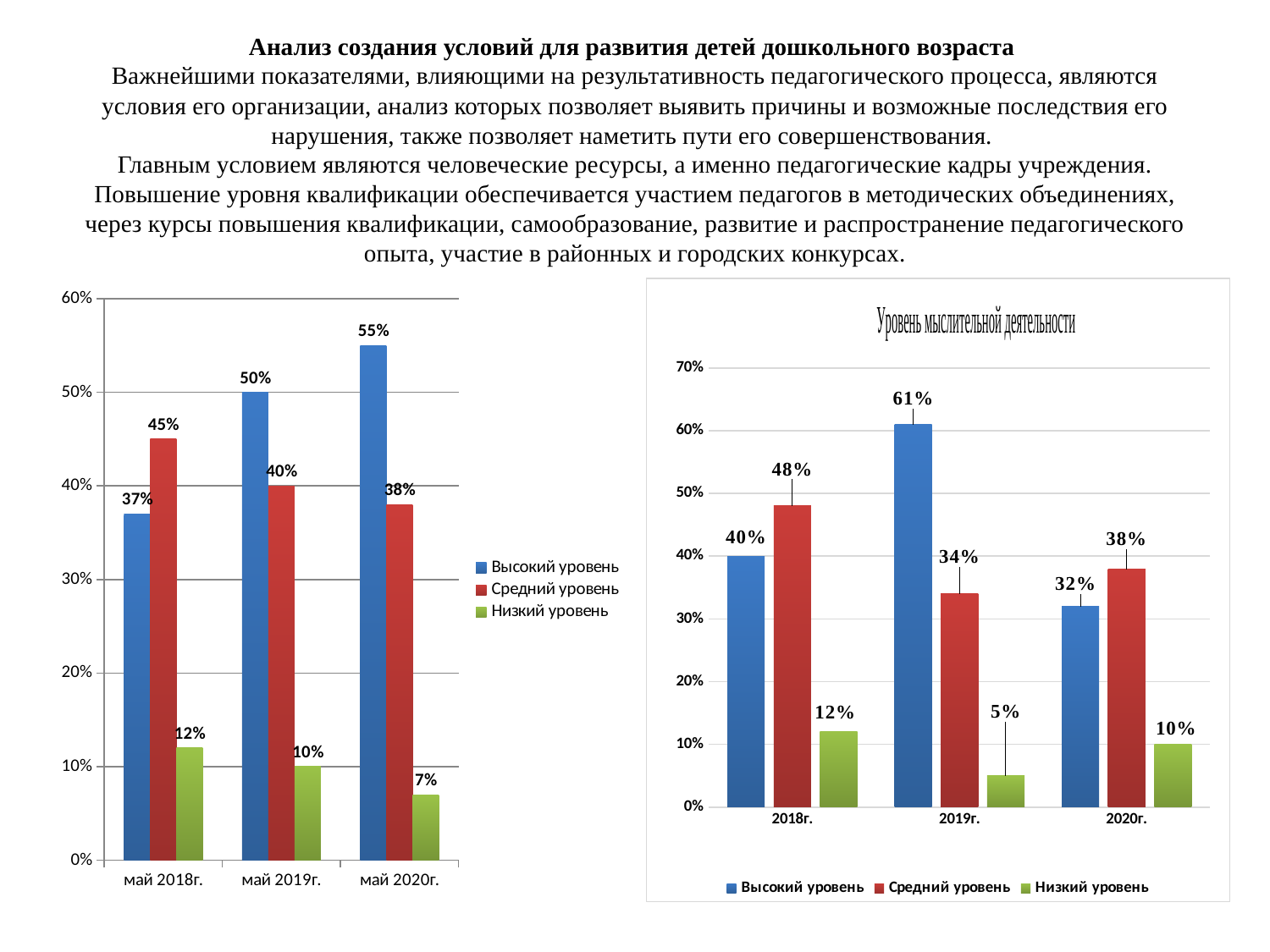
In the left chart, which category has the highest value for Высокий уровень? май 2020г. In the left chart, does Высокий уровень rise or fall from май 2018г. to май 2020г.? rise In the chart titled 'Уровень мыслительной деятельности', what is the value for Высокий уровень in 2019г.? 61% In the left chart, what is the value for Высокий уровень in май 2020г.? 55% In the chart titled 'Уровень мыслительной деятельности', what is the value for Низкий уровень in 2019г.? 5% In the chart titled 'Уровень мыслительной деятельности', what is the difference between Средний уровень in 2018г. and 2019г.? 14% In the left chart, how many series does the legend list? 3 In the chart titled 'Уровень мыслительной деятельности', which year has the lowest value for Высокий уровень? 2020г. In the left chart, what is the value for Низкий уровень in май 2018г.? 12% What type of chart is the chart titled 'Уровень мыслительной деятельности'? bar chart In the left chart, what is the difference between Высокий уровень and Средний уровень in май 2019г.? 10% In the chart titled 'Уровень мыслительной деятельности', which is larger in 2018г.: Высокий уровень or Средний уровень? Средний уровень